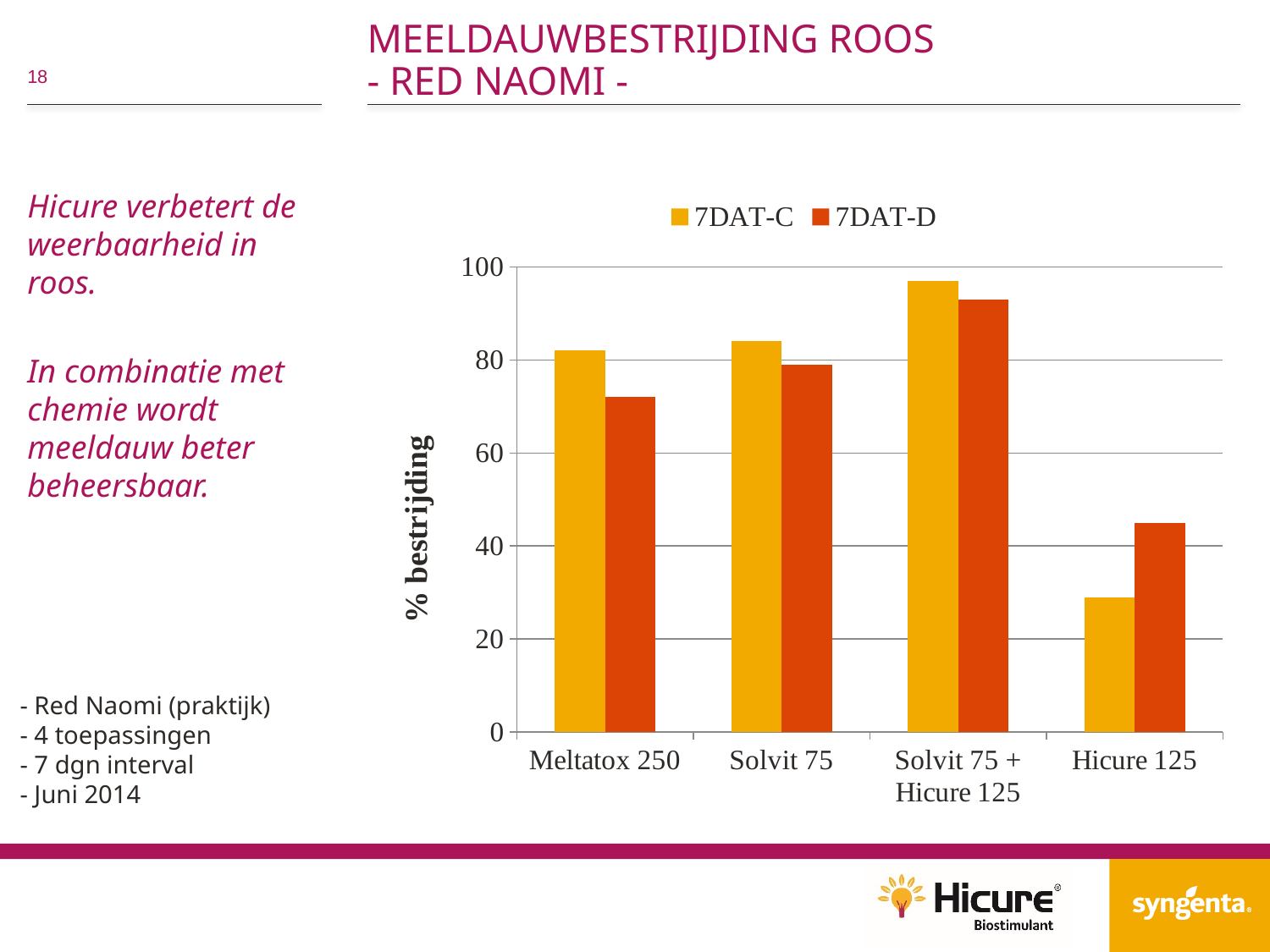
What kind of chart is shown on the slide? bar chart Which category has the highest 7DAT-C value? Solvit 75 + Hicure 125 Which category has the lowest 7DAT-C value? Hicure 125 How many series does the legend list? 2 What is the label of the y axis? % bestrijding Is the 7DAT-C value for Meltatox 250 greater or less than 80? greater Is the 7DAT-D value for Hicure 125 greater or less than 60? less Which category has the lowest 7DAT-D value? Hicure 125 Is the 7DAT-C value for Hicure 125 greater or less than 40? less For Hicure 125, which series has the larger value, 7DAT-C or 7DAT-D? 7DAT-D For Meltatox 250, which series has the larger value, 7DAT-C or 7DAT-D? 7DAT-C How many categories are shown on the x axis? 4